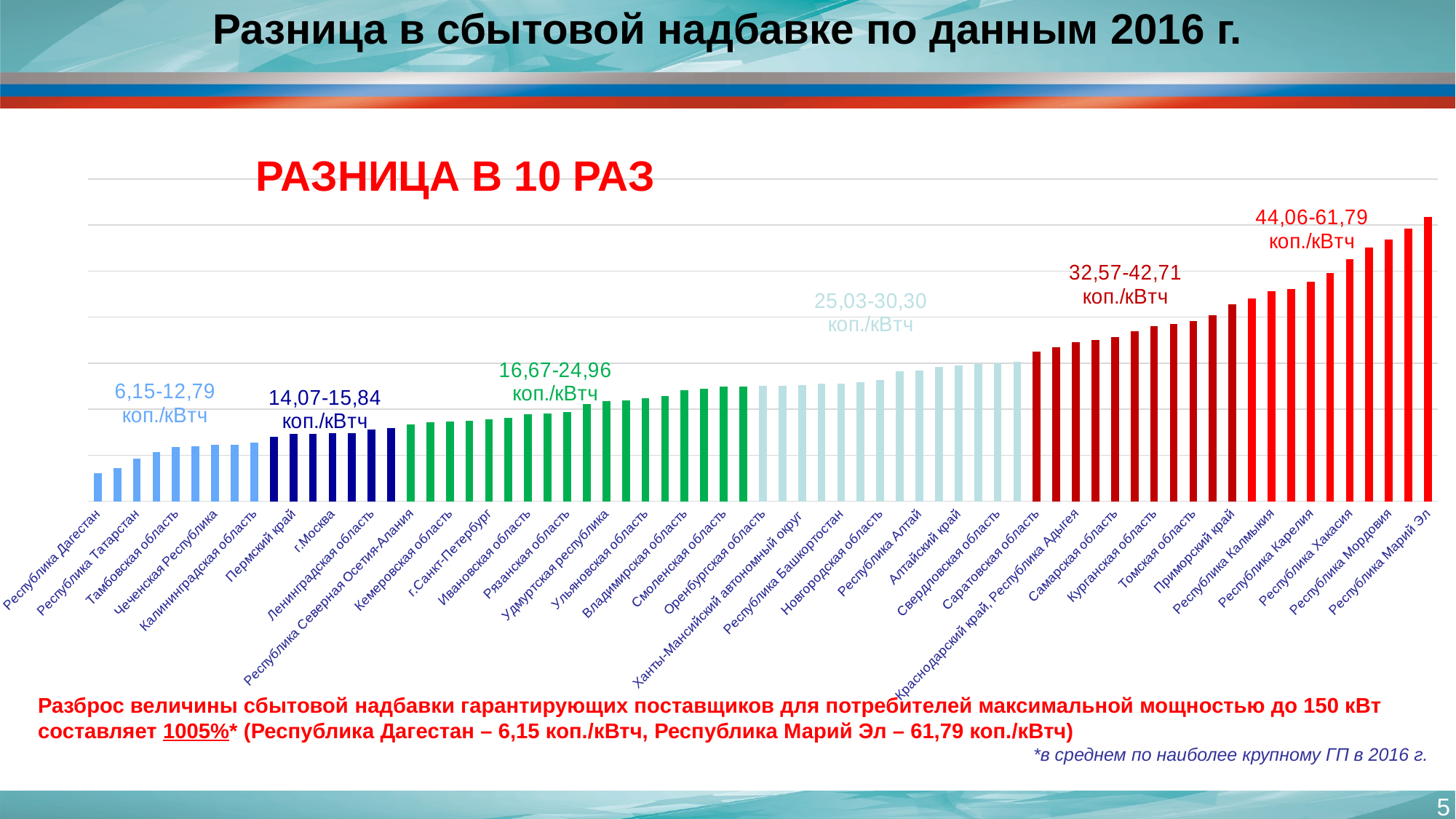
What kind of chart is shown on the slide? bar chart What value range is labelled for the red group of bars on the right? 44,06-61,79 коп./кВтч What is the sales markup value for Республика Марий Эл? 61,79 коп./кВтч What is the difference between the sales markup of Республика Марий Эл and Республика Дагестан? 55,64 коп./кВтч Do the bar values rise or fall from left to right along the x axis? rise Which region has the highest sales markup on the chart? Республика Марий Эл What is the sales markup value for Республика Дагестан? 6,15 коп./кВтч Which has a larger sales markup, г.Москва or Самарская область? Самарская область Which region has the lowest sales markup on the chart? Республика Дагестан What is the title of the slide? Разница в сбытовой надбавке по данным 2016 г. Which has a larger sales markup, Кемеровская область or Республика Татарстан? Кемеровская область